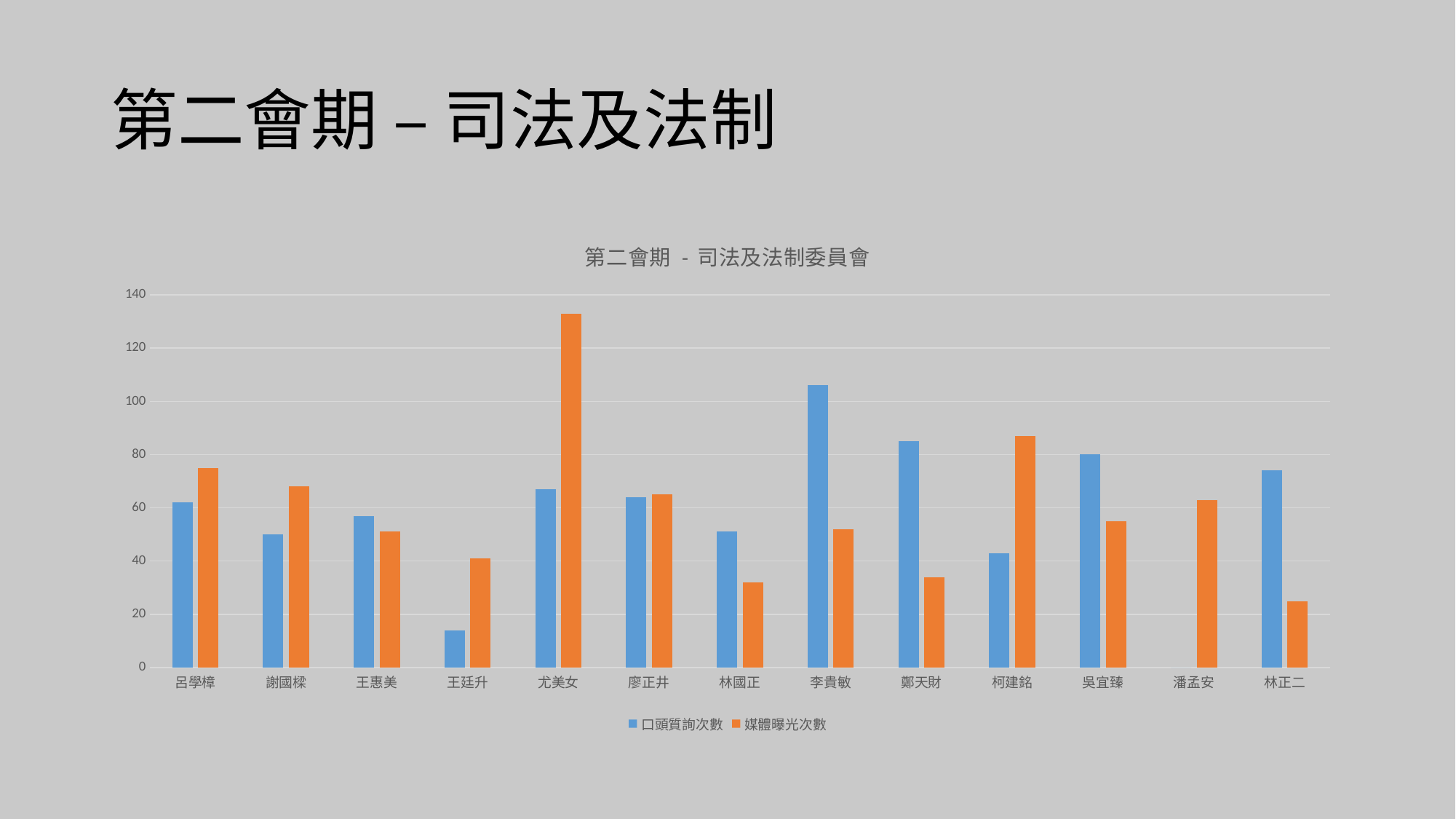
For 鄭天財, which is larger: 口頭質詢次數 or 媒體曝光次數? 口頭質詢次數 How many categories (legislators) are shown on the x axis? 13 Is the 媒體曝光次數 value for 尤美女 greater or less than 120? greater What kind of chart is shown on the slide? bar chart Which category has the highest 媒體曝光次數 value? 尤美女 What is the title of the chart? 第二會期 - 司法及法制委員會 Is the 口頭質詢次數 value for 王廷升 greater or less than 20? less Is the 媒體曝光次數 value for 柯建銘 greater or less than 80? greater Which category has the highest 口頭質詢次數 value? 李貴敏 For 呂學樟, which is larger: 口頭質詢次數 or 媒體曝光次數? 媒體曝光次數 How many series does the legend list? 2 Which category has the lowest 媒體曝光次數 value? 林正二